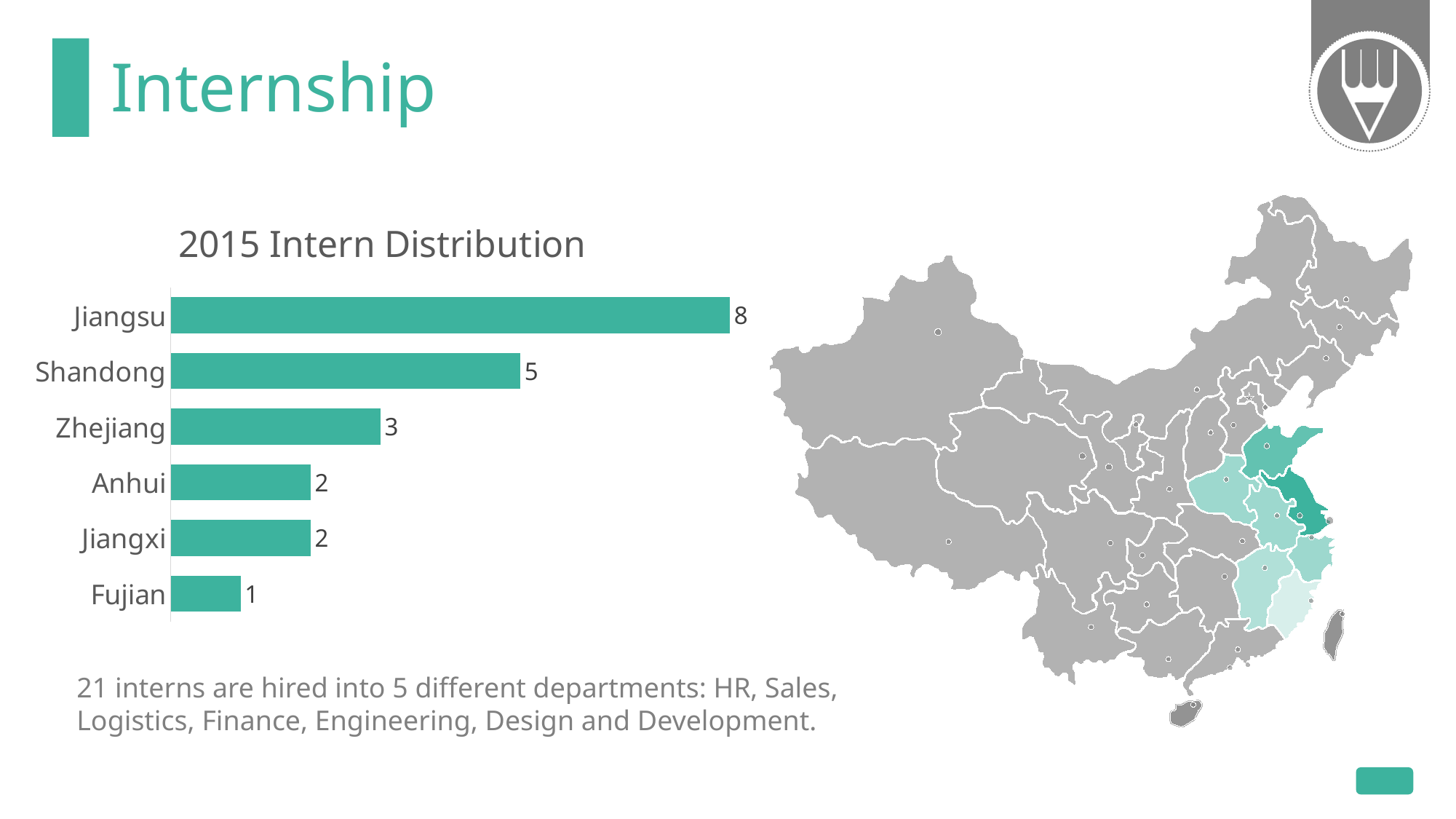
How many provinces are shown in the 2015 Intern Distribution chart? 6 What is the value for Jiangsu in the 2015 Intern Distribution chart? 8 What is the total of all values shown in the 2015 Intern Distribution chart? 21 What is the value for Fujian in the 2015 Intern Distribution chart? 1 Which province has the lowest value in the 2015 Intern Distribution chart? Fujian What is the value for Shandong in the 2015 Intern Distribution chart? 5 What is the title of the chart on the slide? 2015 Intern Distribution Which is larger in the 2015 Intern Distribution chart, the value for Zhejiang or the value for Anhui? Zhejiang What is the difference between the values for Jiangsu and Shandong in the 2015 Intern Distribution chart? 3 What kind of chart is the 2015 Intern Distribution chart? Bar chart Which province has the highest value in the 2015 Intern Distribution chart? Jiangsu What is the value for Zhejiang in the 2015 Intern Distribution chart? 3